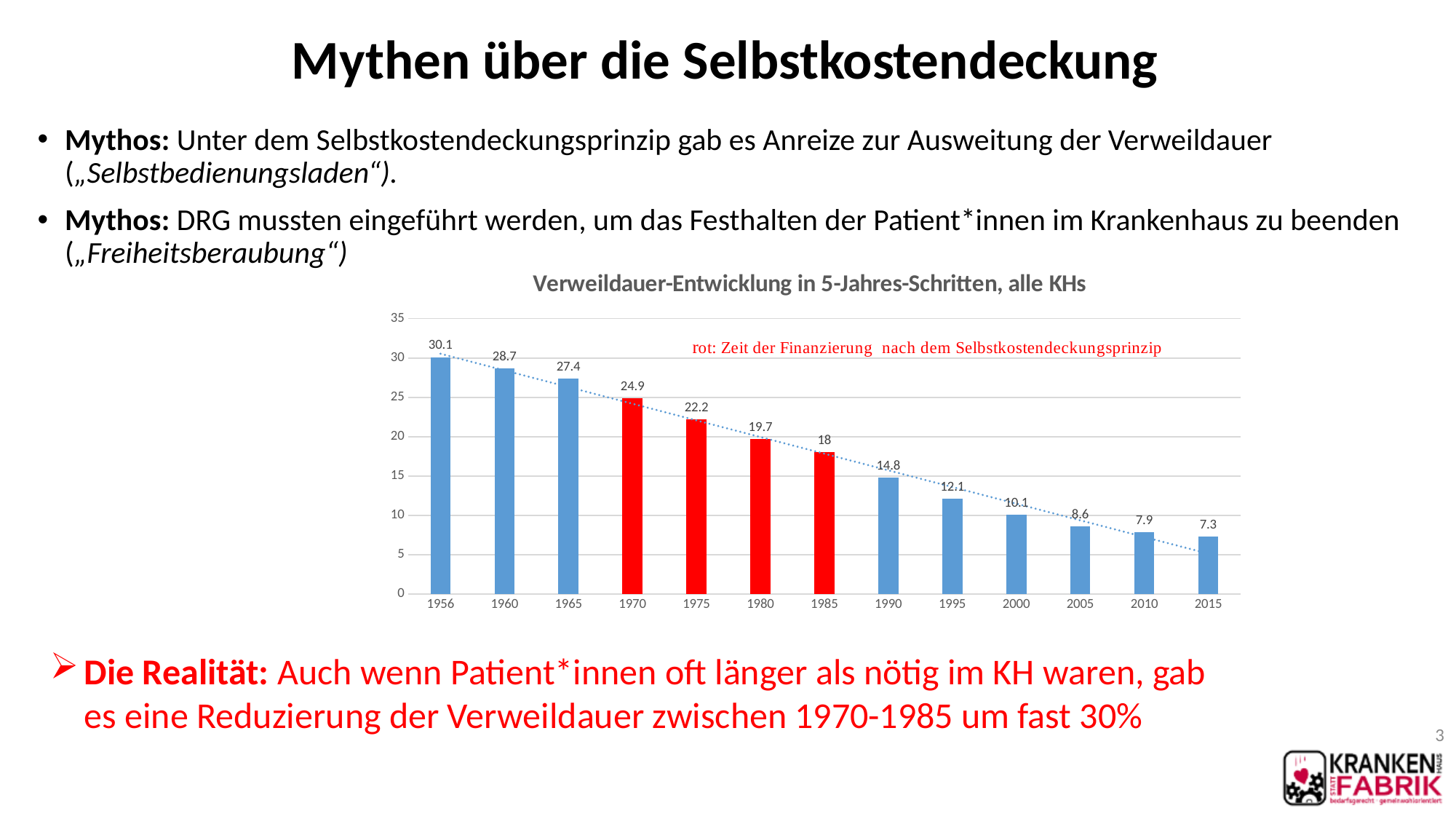
What is the value for 1985? 18 What is the value for 1970? 24.9 What is the difference between the values for 1970 and 1985? 6.9 What is the value for 2015? 7.3 How many years are shown on the x axis? 13 Do the values rise or fall from 1956 to 2015? fall Which year has the highest value? 1956 What is the title of the chart? Verweildauer-Entwicklung in 5-Jahres-Schritten, alle KHs Is the value for 1980 greater or less than 20? less What kind of chart is this? bar chart Which is larger, the value for 1990 or the value for 1995? 1990 Which year has the lowest value? 2015